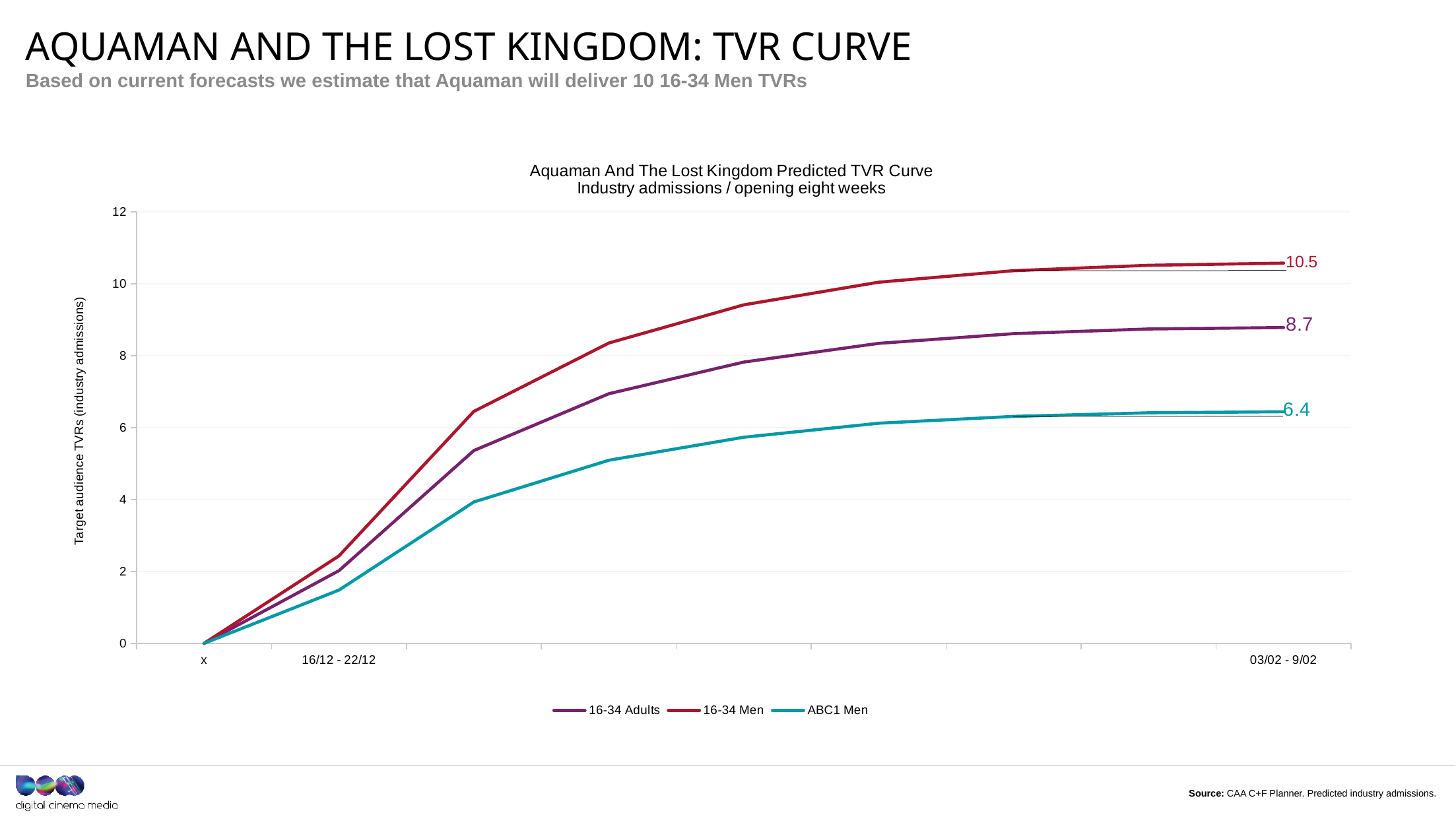
What is the difference between the final values for 16-34 Men and 16-34 Adults? 1.8 What is the final value for 16-34 Adults at the end of the curve? 8.7 Which series reaches the highest value at the end of the curve? 16-34 Men What kind of chart is shown on the slide? line chart Which series reaches the lowest value at the end of the curve? ABC1 Men Is the value for ABC1 Men at 16/12 - 22/12 greater or less than 2? less What is the final value for 16-34 Men at the end of the curve? 10.5 What is the difference between the final values for 16-34 Men and ABC1 Men? 4.1 What is the final value for ABC1 Men at the end of the curve? 6.4 What is the title of the y axis? Target audience TVRs (industry admissions) How many series does the legend list? 3 Do the values for 16-34 Adults rise or fall along the x axis? rise